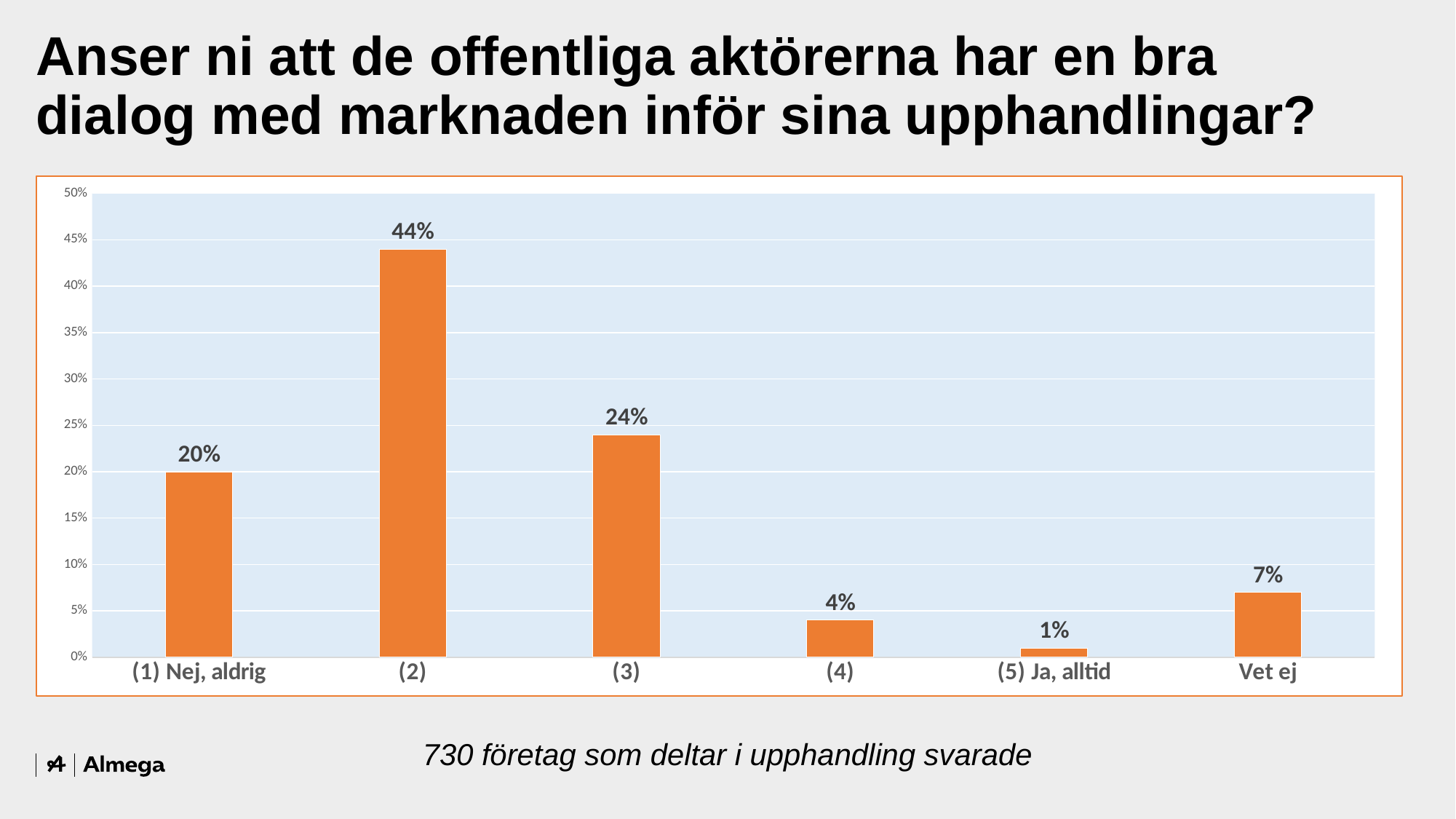
What kind of chart is shown on the slide? Bar chart What is the value for (2)? 44% What is the value for (5) Ja, alltid? 1% What is the difference between the values for Vet ej and (4)? 3% Which category has the highest value? (2) What is the difference between the values for (2) and (3)? 20% Which is larger, the value for (3) or the value for (1) Nej, aldrig? (3) Which category has the lowest value? (5) Ja, alltid What is the highest value shown on the y axis? 50% What is the value for Vet ej? 7% How many categories are shown on the x axis? 6 What is the value for (1) Nej, aldrig? 20%